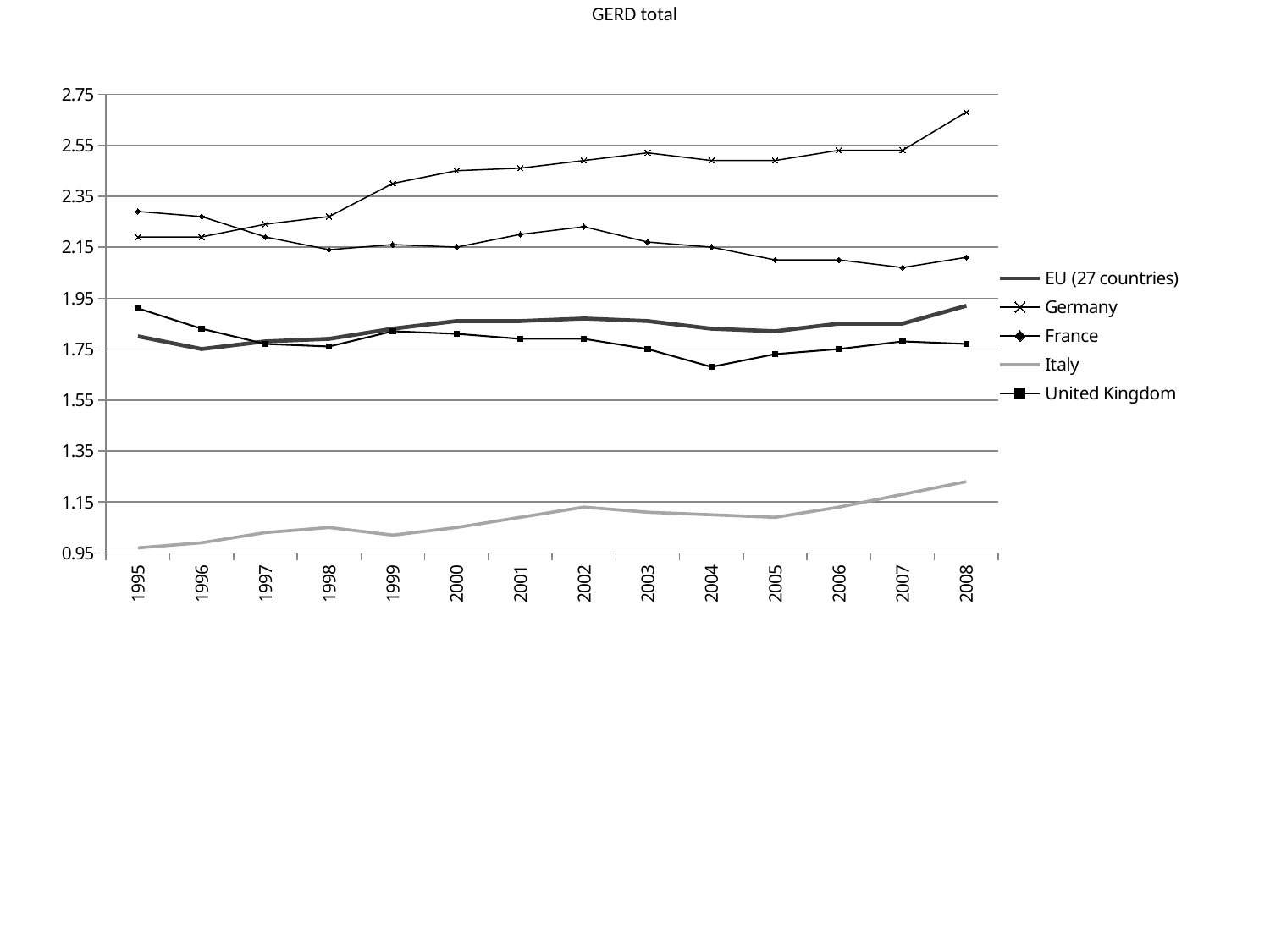
In 2004, which is larger: the value for EU (27 countries) or the value for United Kingdom? EU (27 countries) What kind of chart is shown on the slide? line chart Is the value for France in 2007 greater or less than 2.15? less Which series has the highest value in 2008? Germany Does the Germany line rise or fall overall from 1995 to 2008? rises Which series has the lowest value in 2008? Italy How many years are shown along the x axis? 14 In 1995, which is larger: the value for Germany or the value for France? France How many series does the legend list? 5 Is the value for Italy in 1995 greater or less than 1.15? less Is the value for Germany in 2008 greater or less than 2.55? greater What is the title of the chart? GERD total